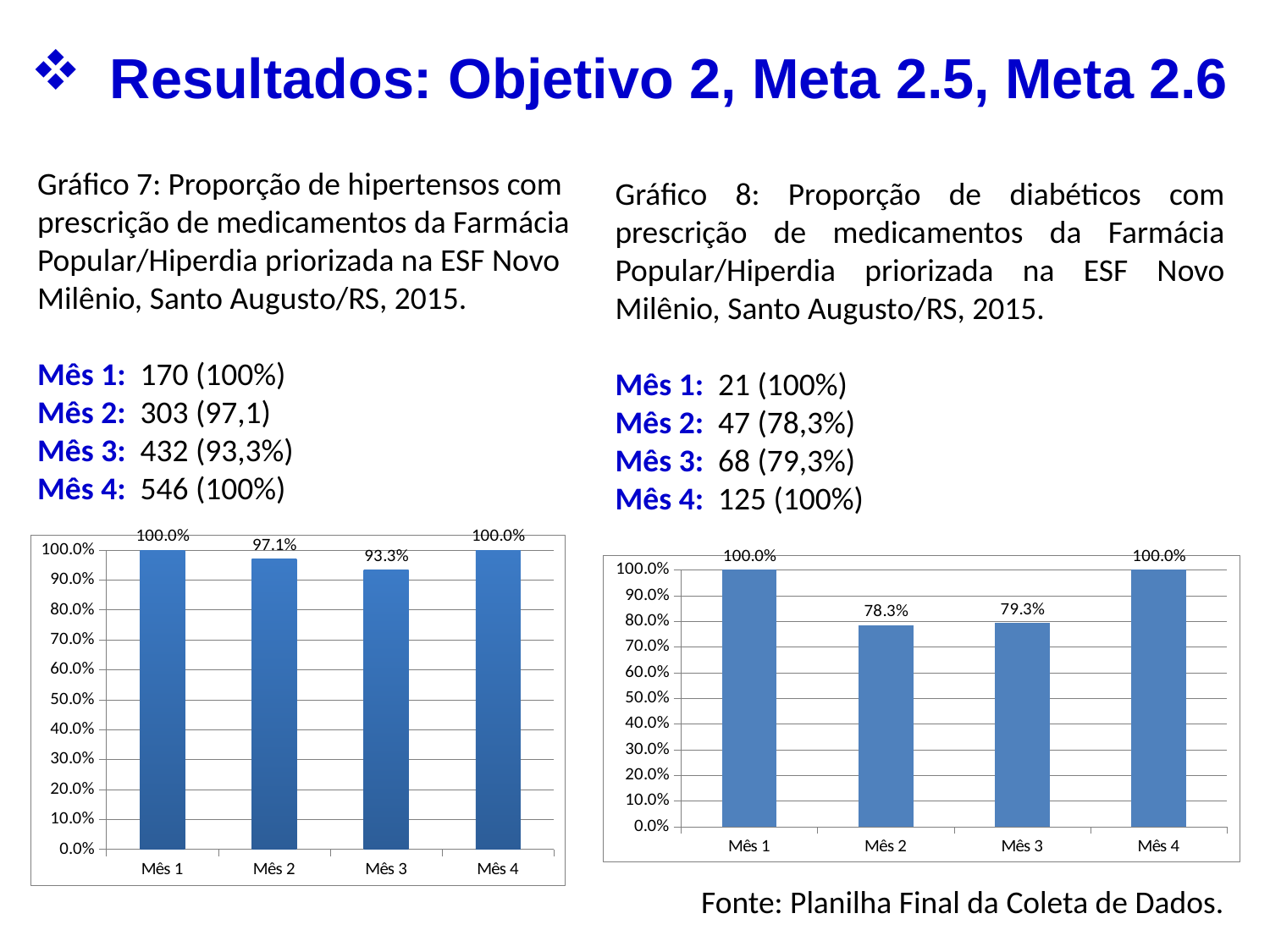
In the right chart (Gráfico 8), what is the value for Mês 3? 79.3% In the right chart (Gráfico 8), what is the value for Mês 2? 78.3% In the right chart (Gráfico 8), what is the difference between the values for Mês 1 and Mês 2? 21.7% In the left chart (Gráfico 7), what is the value for Mês 3? 93.3% What kind of chart is the right chart (Gráfico 8)? Bar chart How many categories (months) are shown in the left chart (Gráfico 7)? 4 In the right chart (Gráfico 8), which is larger, the value for Mês 2 or Mês 3? Mês 3 In the left chart (Gráfico 7), what is the difference between the values for Mês 2 and Mês 3? 3.8% In the left chart (Gráfico 7), what is the value for Mês 2? 97.1% In the left chart (Gráfico 7), which month has the lowest value? Mês 3 In the right chart (Gráfico 8), is the value for Mês 2 greater or less than 80.0%? less In the right chart (Gráfico 8), which month has the lowest value? Mês 2